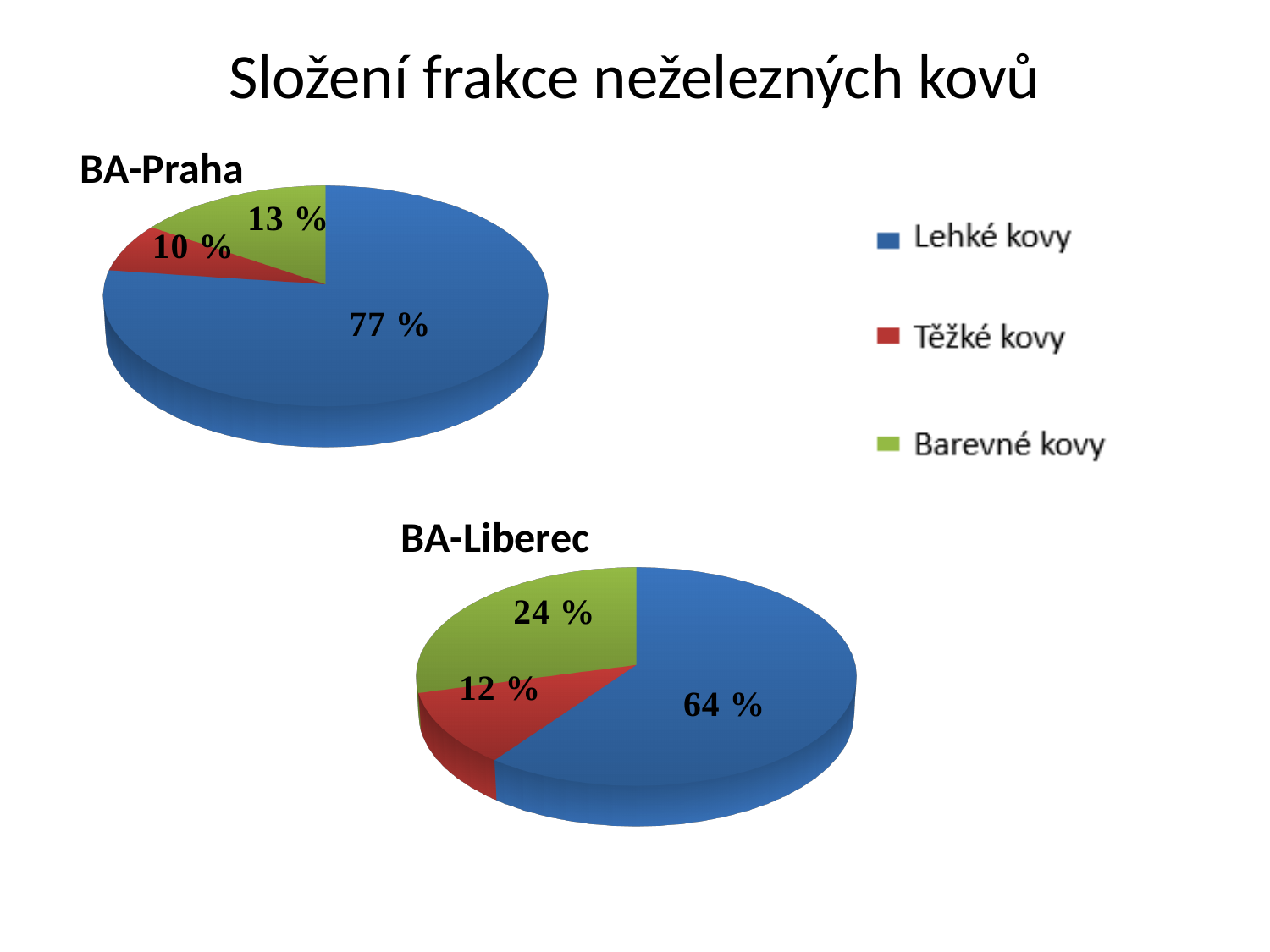
In the BA-Praha chart, which category has the smallest share? Těžké kovy In the BA-Liberec chart, which is larger: Barevné kovy or Těžké kovy? Barevné kovy How many categories does the legend list? 3 What is the difference between the Lehké kovy share in the BA-Praha chart and in the BA-Liberec chart? 13 % In the BA-Praha chart, what share is Barevné kovy? 13 % In the BA-Praha chart, what share is Lehké kovy? 77 % In the BA-Liberec chart, what share is Lehké kovy? 64 % In the BA-Liberec chart, what share is Barevné kovy? 24 % In the BA-Praha chart, what share is Těžké kovy? 10 % What kind of chart is the BA-Praha chart? Pie chart In the BA-Liberec chart, which category has the largest share? Lehké kovy In the BA-Liberec chart, what share is Těžké kovy? 12 %